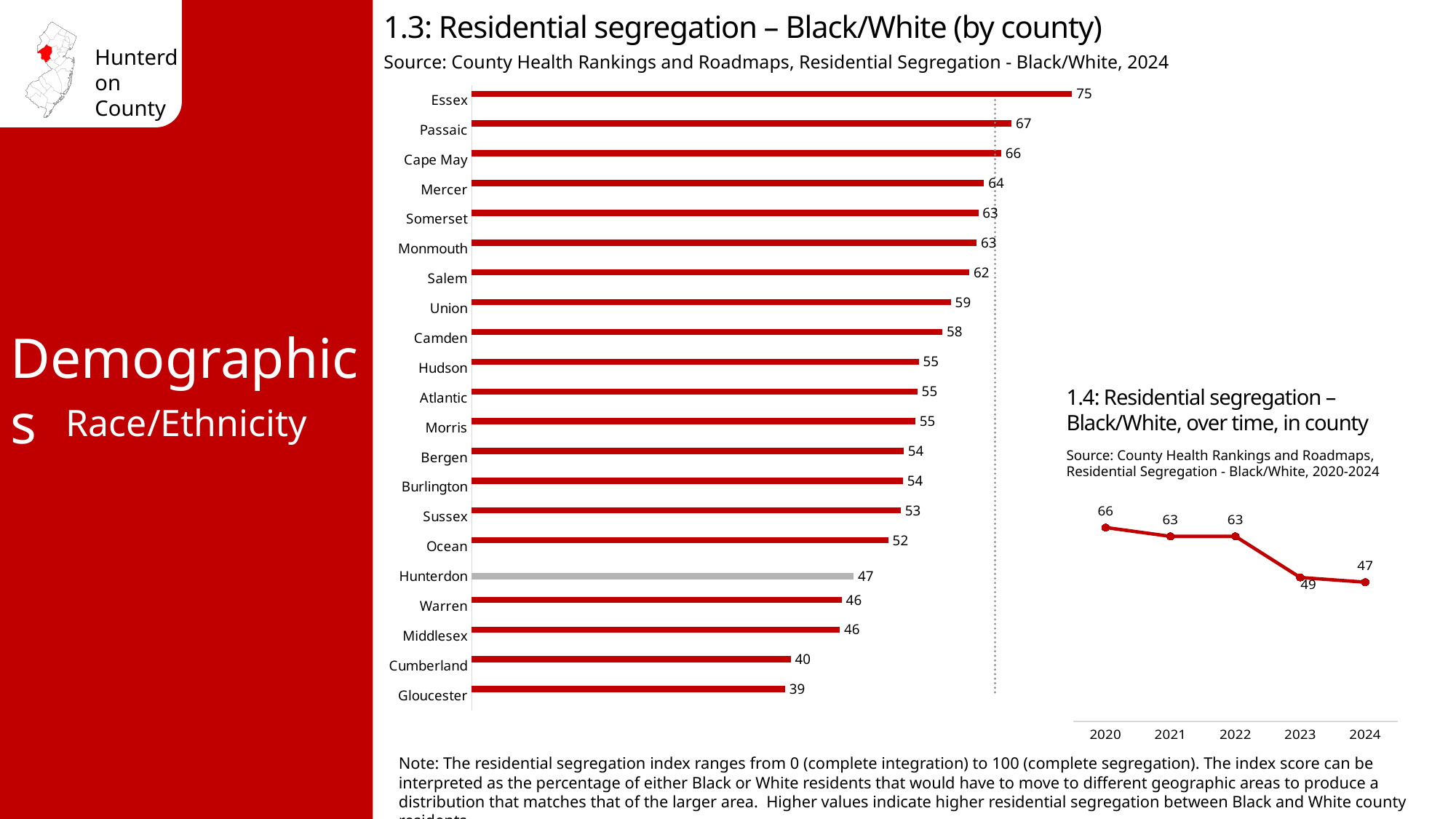
In chart 1.3 (by county), which county has the highest value? Essex In chart 1.3 (by county), which has a larger value, Union or Ocean? Union In chart 1.3 (by county), what is the difference between the values for Essex and Gloucester? 36 In chart 1.3 (by county), which county has the lowest value? Gloucester What kind of chart is chart 1.3 (Residential segregation – Black/White by county)? Bar chart In chart 1.4 (over time, in county), what is the difference between the 2020 and 2024 values? 19 In chart 1.3 (by county), what is the value for Cape May? 66 How many counties are shown in chart 1.3 (by county)? 21 In chart 1.4 (over time, in county), do the values rise or fall from 2020 to 2024? Fall In chart 1.3 (by county), which bar is coloured grey instead of red? Hunterdon In chart 1.4 (over time, in county), what is the value for 2023? 49 In chart 1.3 (Residential segregation – Black/White by county), what is the value for Hunterdon? 47